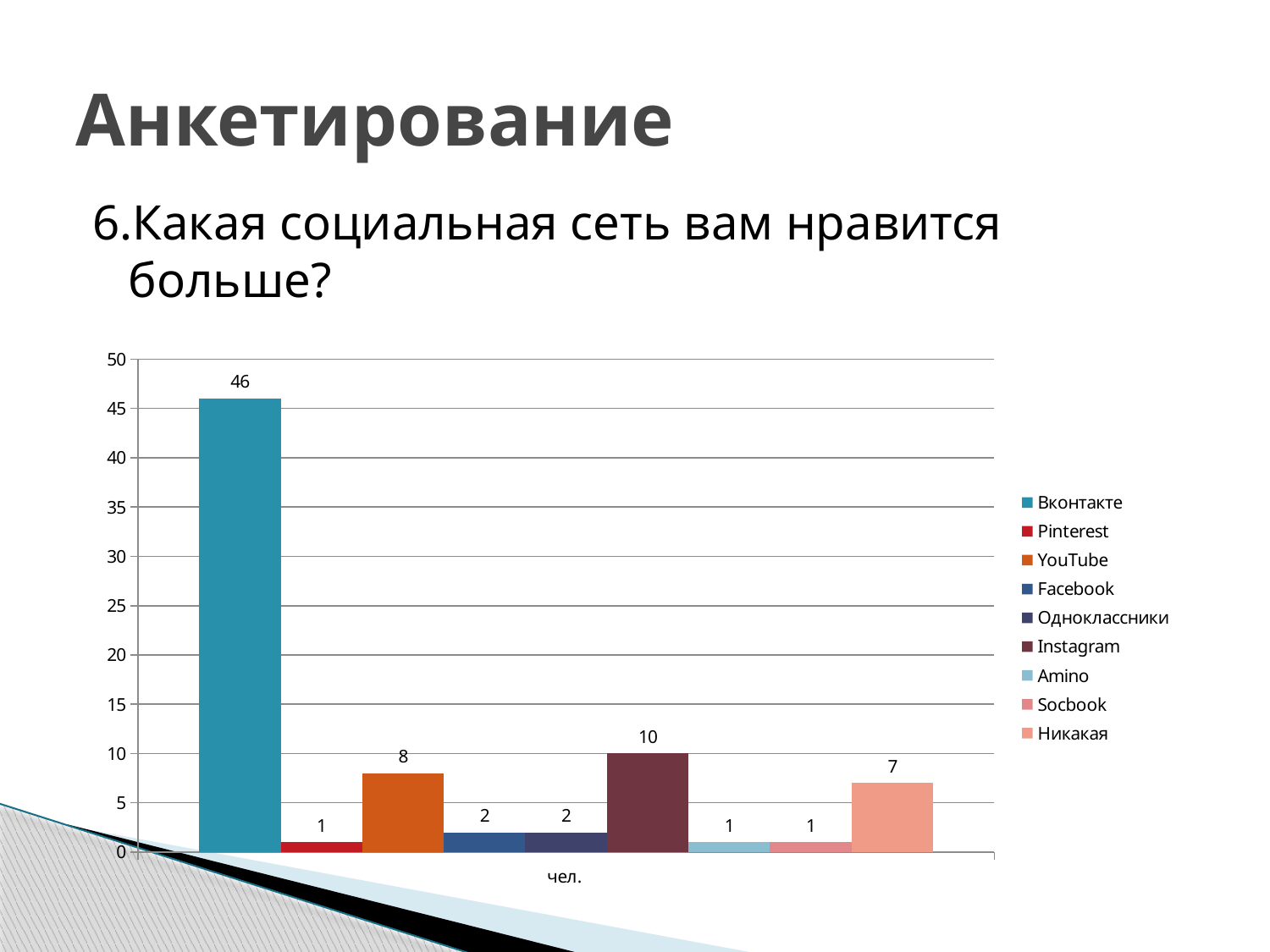
Which is larger, the value for YouTube or the value for Никакая? YouTube What is the label shown on the x axis of the chart? чел. What is the difference between the values for Instagram and YouTube? 2 What value is shown for YouTube? 8 What is the difference between the values for Вконтакте and Instagram? 36 Is the value for Вконтакте greater or less than 40? greater How many series does the legend list? 9 What kind of chart is shown on the slide? bar chart Which social network has the highest value? Вконтакте What value is shown for Никакая? 7 What value is shown for Instagram? 10 What value is shown for Вконтакте? 46